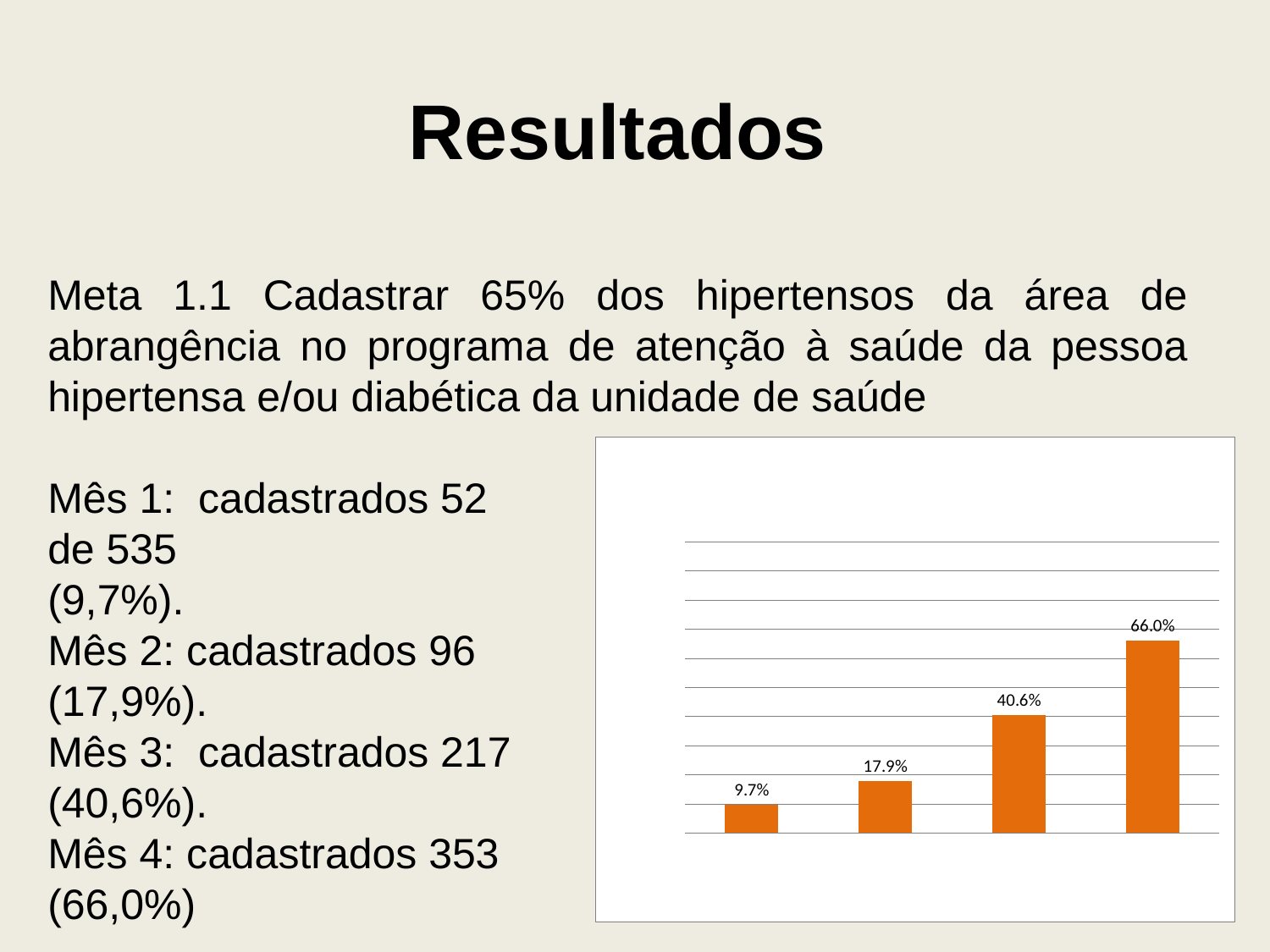
What is the value labelled on the second bar of the chart? 17.9% Which bar in the chart has the highest value? the fourth (rightmost) bar, 66.0% What is the value labelled on the first (leftmost) bar of the chart? 9.7% How many bars does the chart show? 4 Which bar in the chart has the lowest value? the first (leftmost) bar, 9.7% What colour are the bars in the chart? orange What is the value labelled on the fourth (rightmost) bar of the chart? 66.0% What is the difference between the values of the fourth bar and the third bar in the chart? 25.4% What is the value labelled on the third bar of the chart? 40.6% What kind of chart is shown on the slide? bar chart Do the bar values rise or fall from left to right across the chart? rise Which is larger in the chart: the value of the second bar or the value of the third bar? the third bar (40.6%)